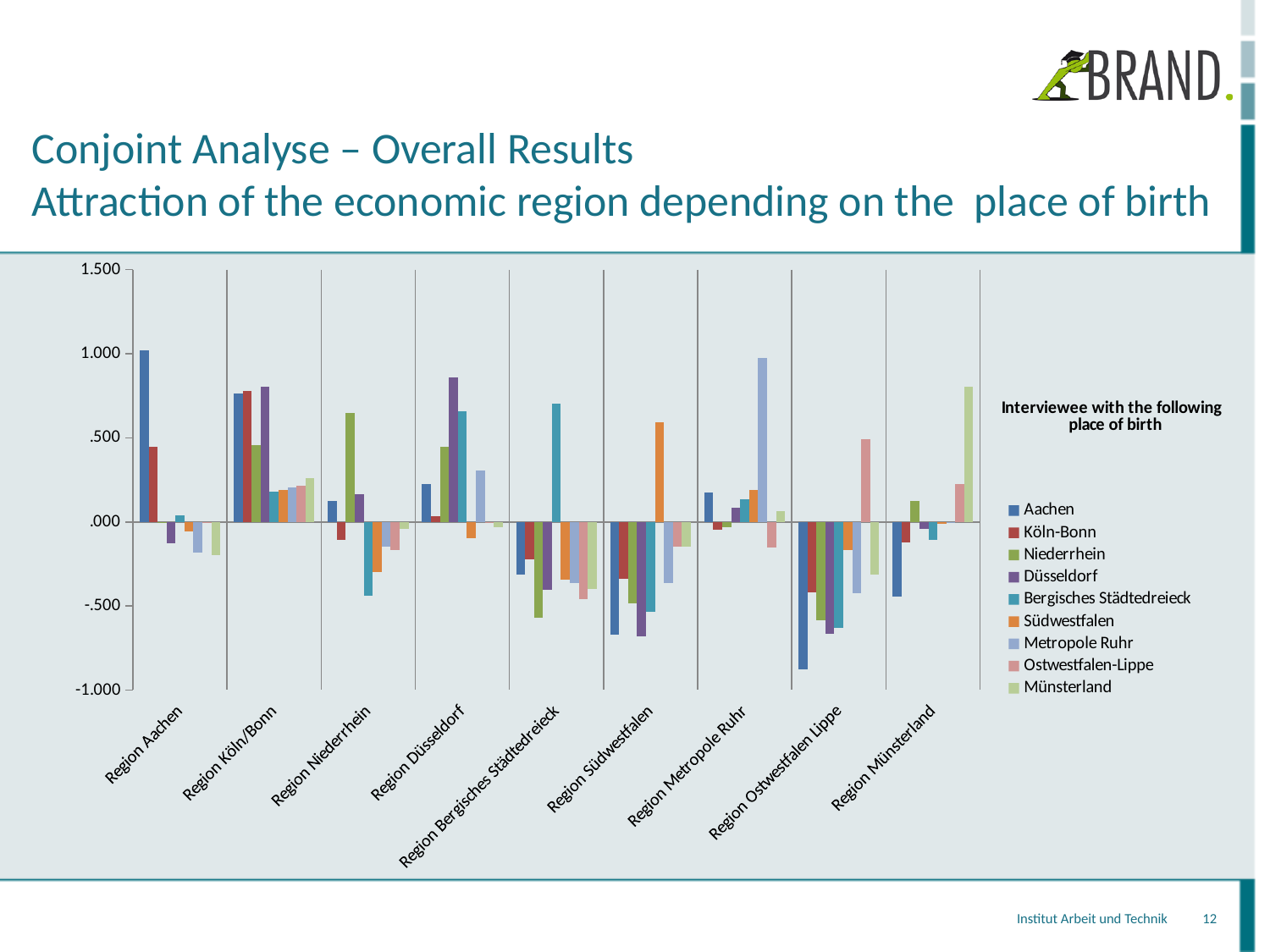
How many series does the chart's legend list? 9 Is the value for the Metropole Ruhr series in Region Metropole Ruhr greater or less than .500? greater What is the title of the chart's legend? Interviewee with the following place of birth How many regions are shown along the x axis of the chart? 9 In Region Niederrhein, which is larger: the value for Niederrhein or the value for Aachen? Niederrhein What kind of chart is shown on the slide? bar chart Which series has the highest value in Region Bergisches Städtedreieck? Bergisches Städtedreieck In Region Südwestfalen, which is larger: the value for Südwestfalen or the value for Köln-Bonn? Südwestfalen Is the value for the Münsterland series in Region Münsterland greater or less than .500? greater Is the value for the Aachen series in Region Ostwestfalen Lippe greater or less than -.500? less Which series has the lowest value in Region Ostwestfalen Lippe? Aachen